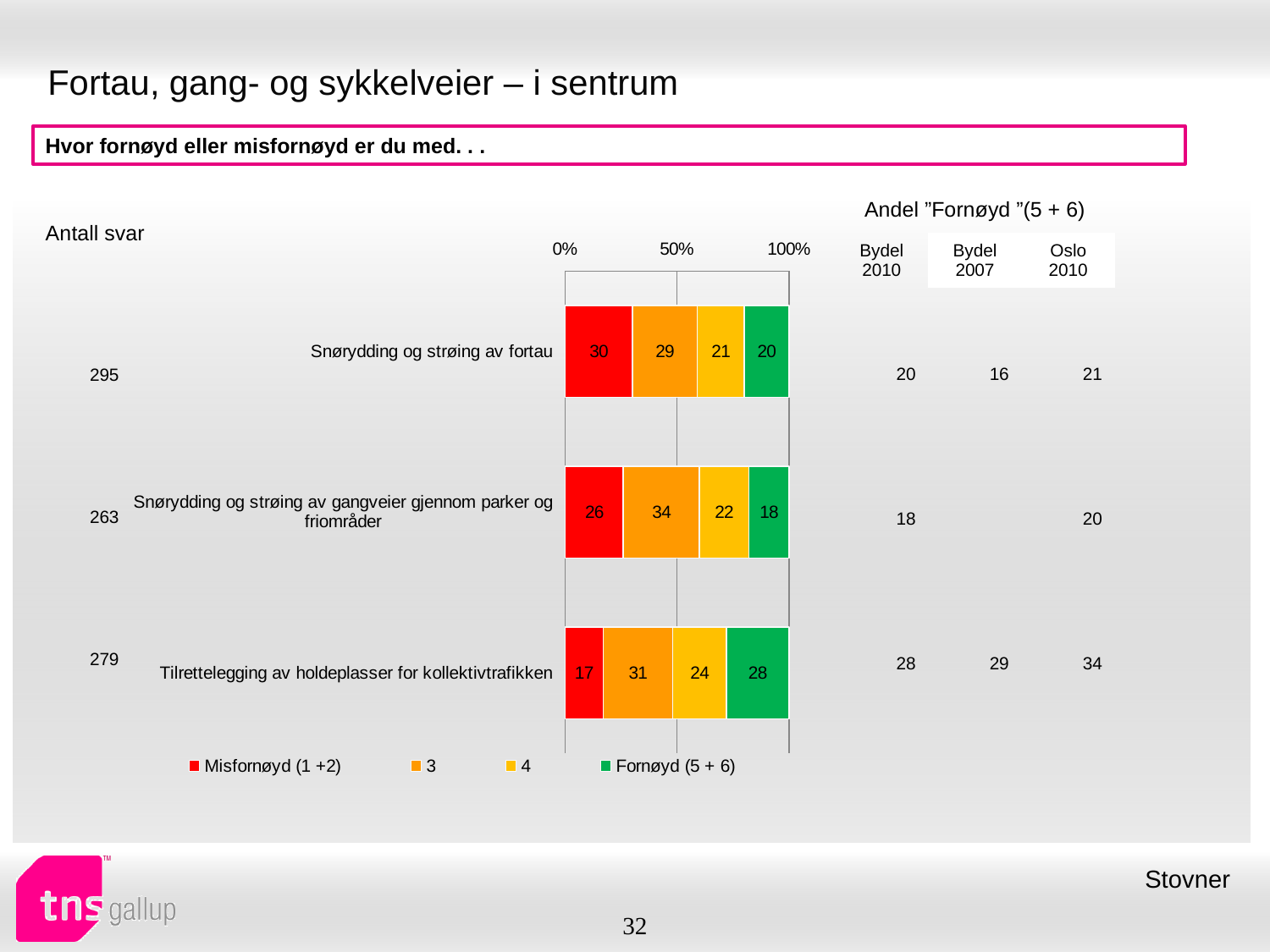
Which category has the lowest "Misfornøyd (1 +2)" value? Tilrettelegging av holdeplasser for kollektivtrafikken What is the total of the stacked bar for "Snørydding og strøing av gangveier gjennom parker og friområder"? 100 What kind of chart is shown on the slide? Stacked bar chart What is the difference between the "Misfornøyd (1 +2)" values for "Snørydding og strøing av fortau" and "Tilrettelegging av holdeplasser for kollektivtrafikken"? 13 What colour represents the "Fornøyd (5 + 6)" series in the legend? Green Which is larger: the "4" segment for "Snørydding og strøing av fortau" or the "4" segment for "Tilrettelegging av holdeplasser for kollektivtrafikken"? Tilrettelegging av holdeplasser for kollektivtrafikken What is the value of the "Misfornøyd (1 +2)" segment for "Snørydding og strøing av fortau"? 30 What is the value of the "3" segment for "Snørydding og strøing av gangveier gjennom parker og friområder"? 34 What is the value of the "Fornøyd (5 + 6)" segment for "Tilrettelegging av holdeplasser for kollektivtrafikken"? 28 How many categories are shown in the chart? 3 How many series does the legend list? 4 Which category has the highest "Fornøyd (5 + 6)" value? Tilrettelegging av holdeplasser for kollektivtrafikken